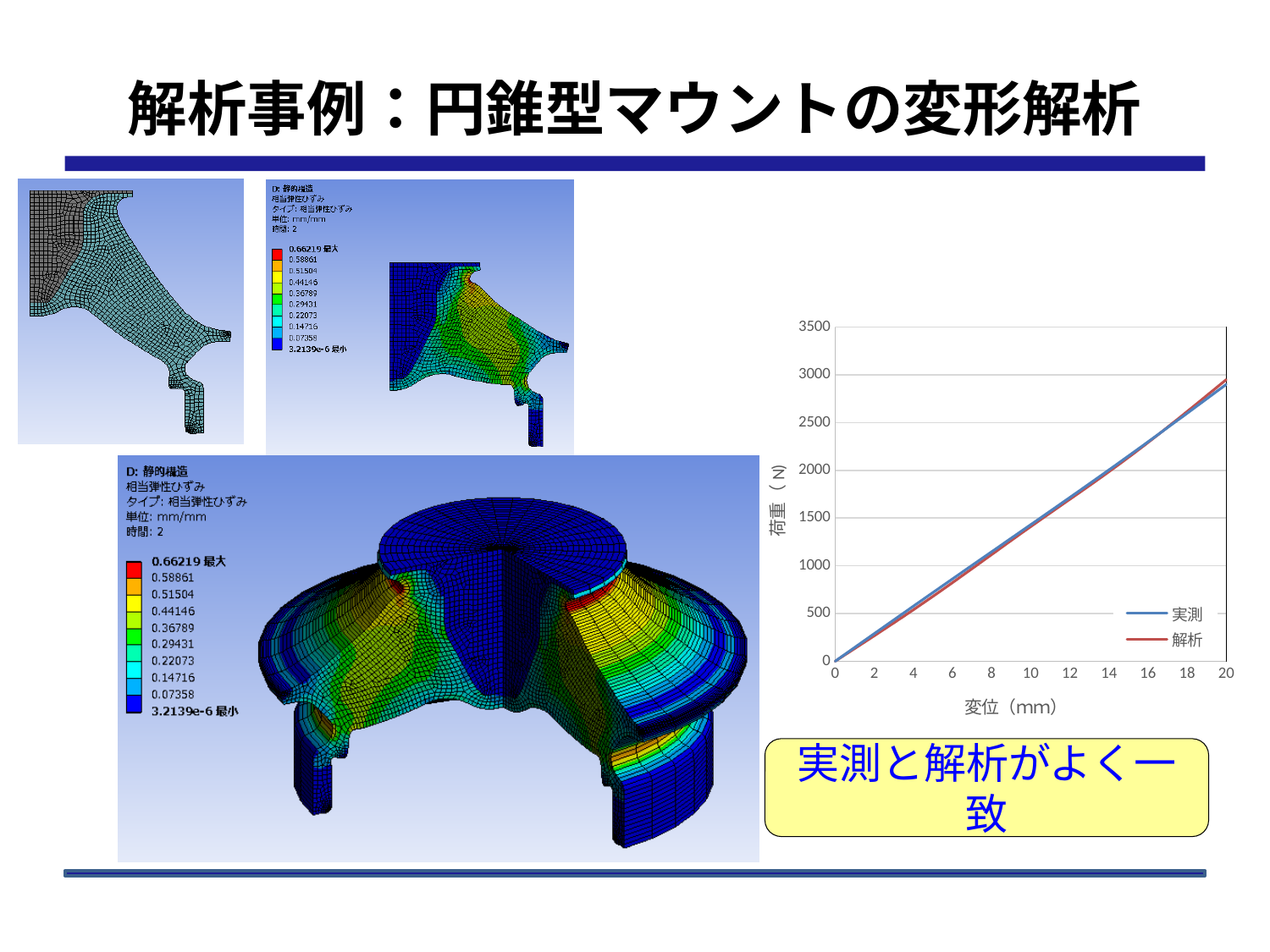
In the line chart, is the load for 実測 at a displacement of 12 mm greater or less than 2000? less In the line chart, is the load for 解析 at a displacement of 8 mm greater or less than 1000? greater In the line chart, is the load for 実測 at a displacement of 16 mm greater or less than 2000? greater How many series does the legend of the line chart list? 2 What kind of chart is shown on the right side of the slide? line chart What is the label of the x axis of the line chart? 変位（mm） Do the values in the line chart rise or fall as displacement increases from 0 to 20 mm? rise What are the two series named in the legend of the line chart? 実測 and 解析 What is the maximum value shown on the y axis of the line chart? 3500